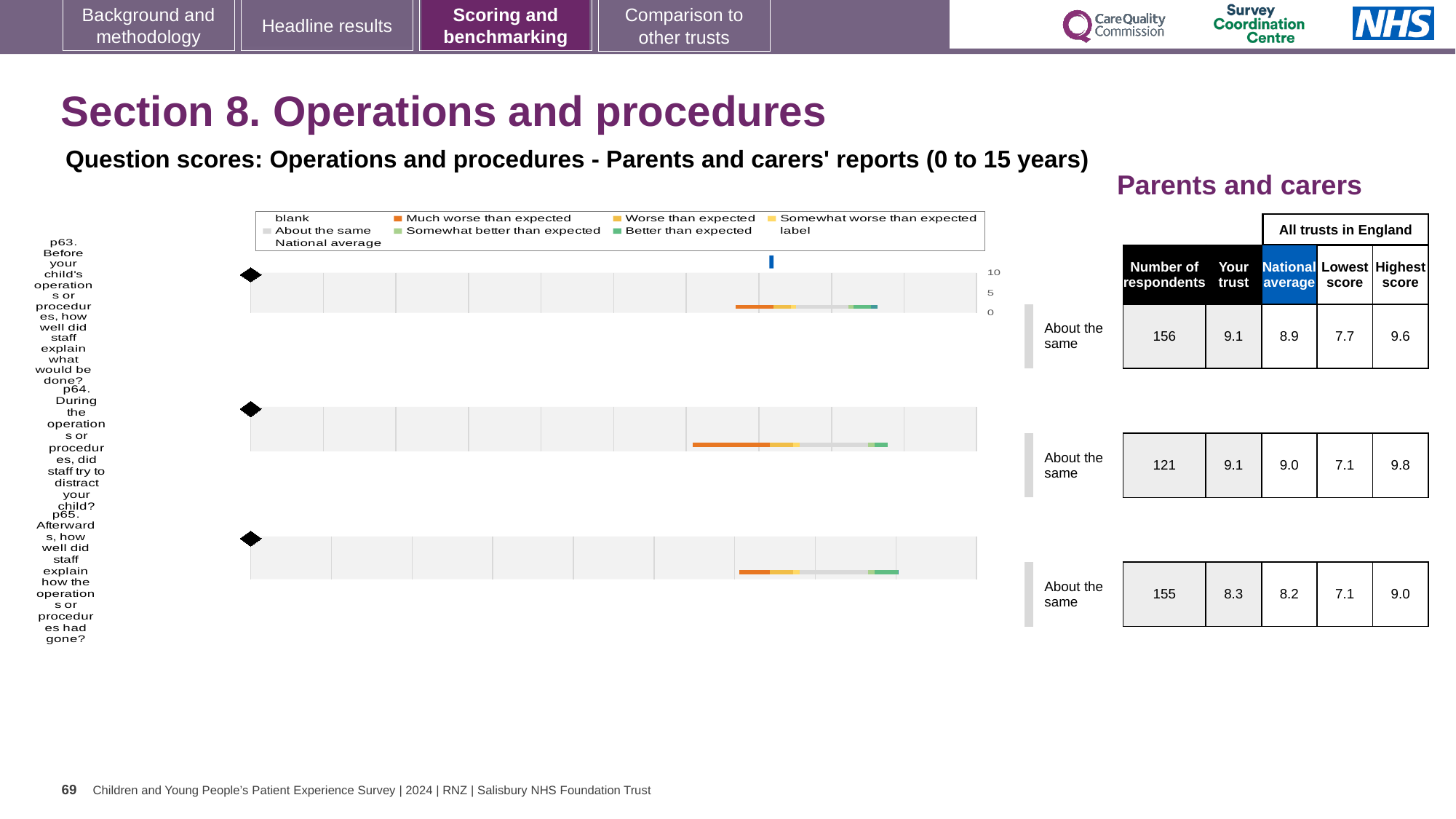
Which question has the lowest 'Your trust' score? p65 Which colour does the legend use for 'Much worse than expected'? orange How many respondents answered p64? 121 What is the difference between the highest score and the lowest score for p63? 1.9 How many questions (p63, p64, p65) are plotted on the slide? 3 What is the national average score for p64 (did staff try to distract your child during the operation)? 9.0 Which question has the fewest respondents? p64 What is the highest score among all trusts in England for p65 (how well staff explained how the operation had gone)? 9.0 What is the 'Your trust' score for p63 (how well staff explained what would be done before the operation)? 9.1 What kind of chart is used to show the question scores on this slide? bar chart Is the 'Your trust' score for p65 higher or lower than the national average for p65? higher What benchmark category is shown for p64? About the same